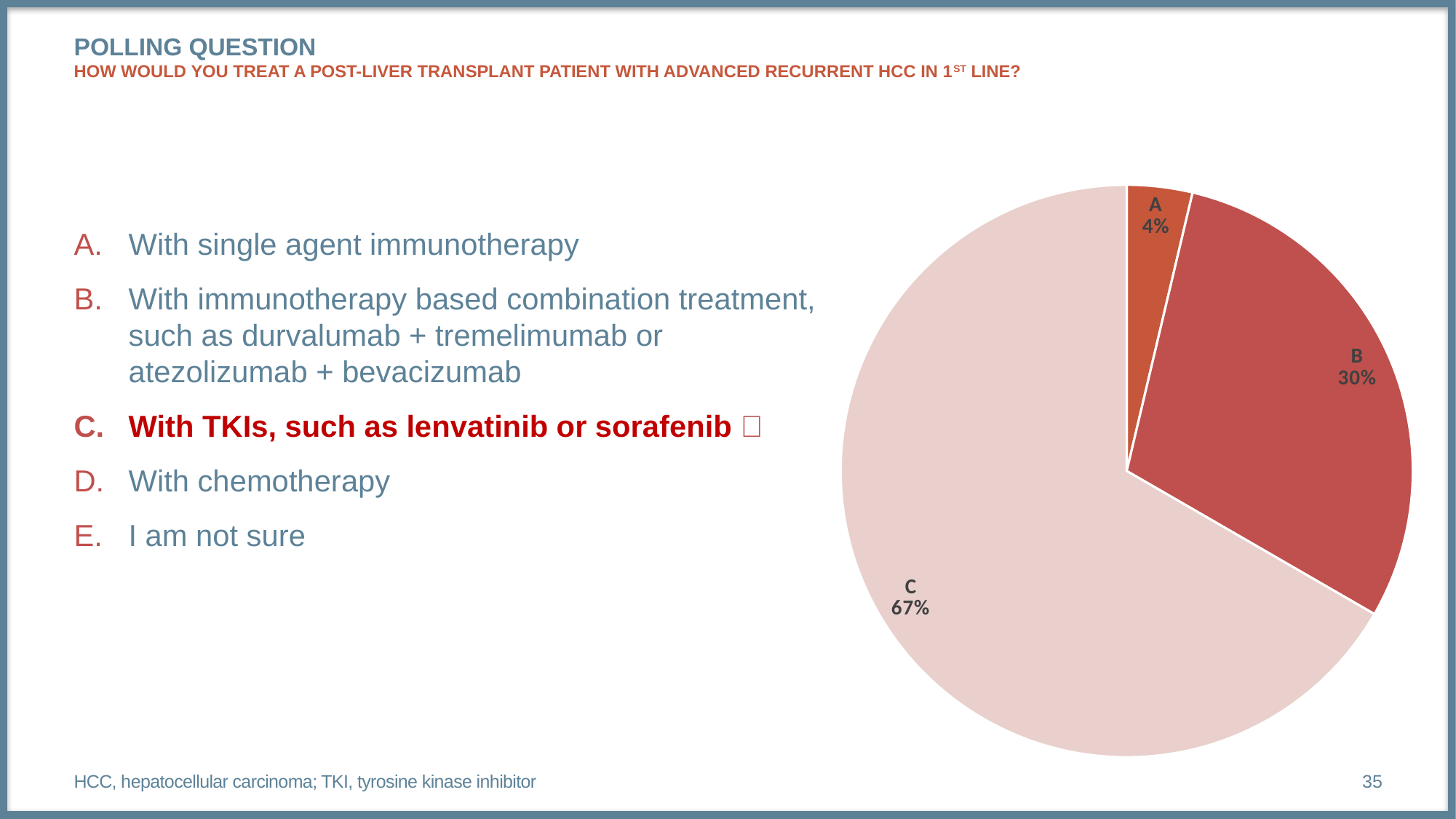
What is the difference in percentage points between slice C and slice B? 37 Which slice is larger, A or B? B What kind of chart is shown on the slide? pie chart What percentage of the pie is labelled C? 67% What is the difference in percentage points between slice B and slice A? 26 Which slice of the pie chart is the largest? C What percentage of the pie is labelled A? 4% Which slice is larger, B or C? C Which slice of the pie chart is the smallest? A What percentage of the pie is labelled B? 30% How many slices does the pie chart have? 3 Which polling option is highlighted in bold red text on the slide? C. With TKIs, such as lenvatinib or sorafenib